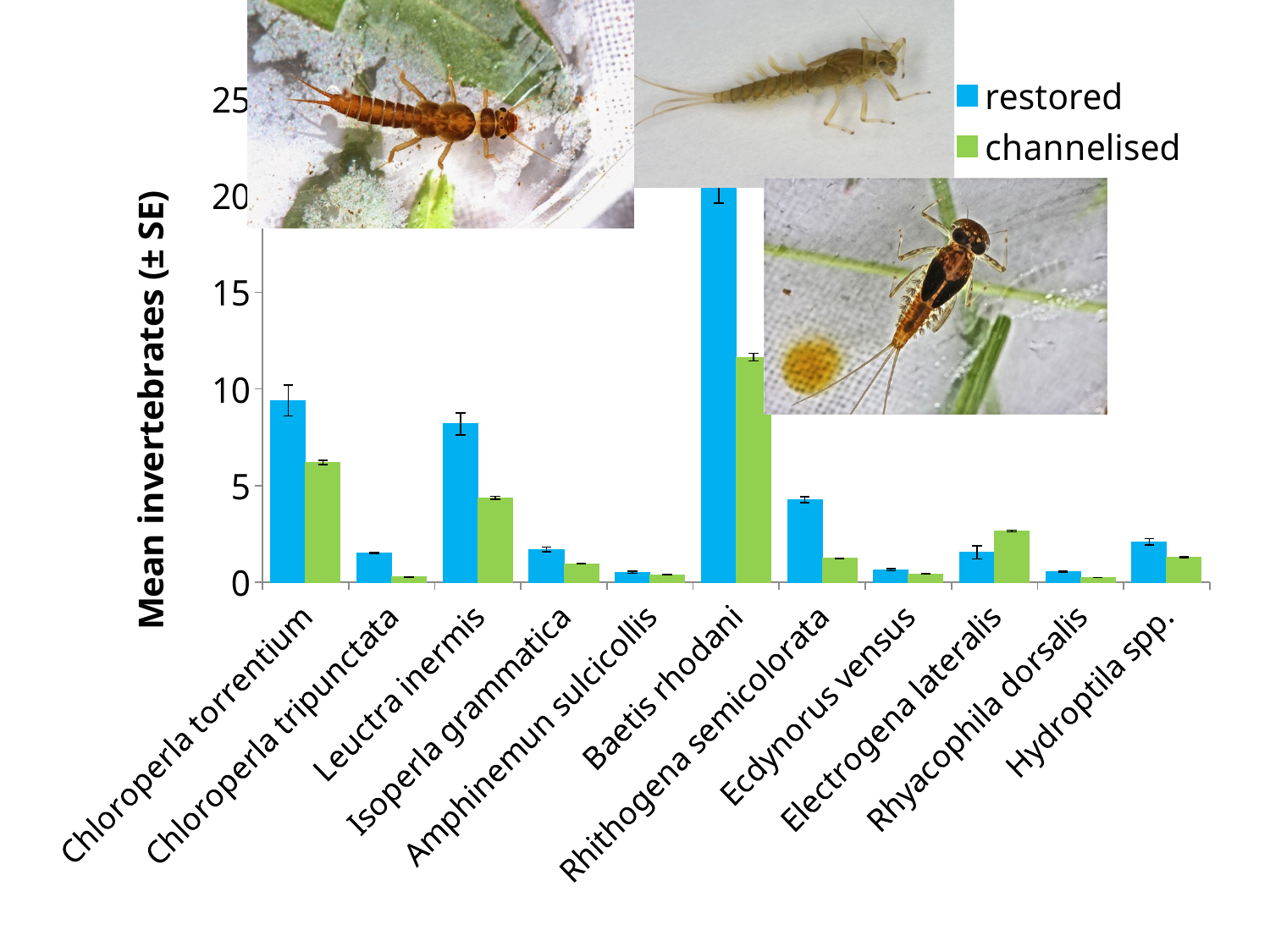
How many series does the legend list? 2 Is the restored value for Rhithogena semicolorata greater or less than 5? less Which species has the highest channelised value? Baetis rhodani For Leuctra inermis, which is larger: the restored or the channelised value? restored Is the channelised value for Baetis rhodani greater or less than 10? greater What is the title of the y axis? Mean invertebrates (± SE) What kind of chart is shown on the slide? bar chart Which species has the highest restored value? Baetis rhodani Is the restored value for Baetis rhodani greater or less than 15? greater How many species categories are shown on the x axis? 11 For Electrogena lateralis, which is larger: the restored or the channelised value? channelised